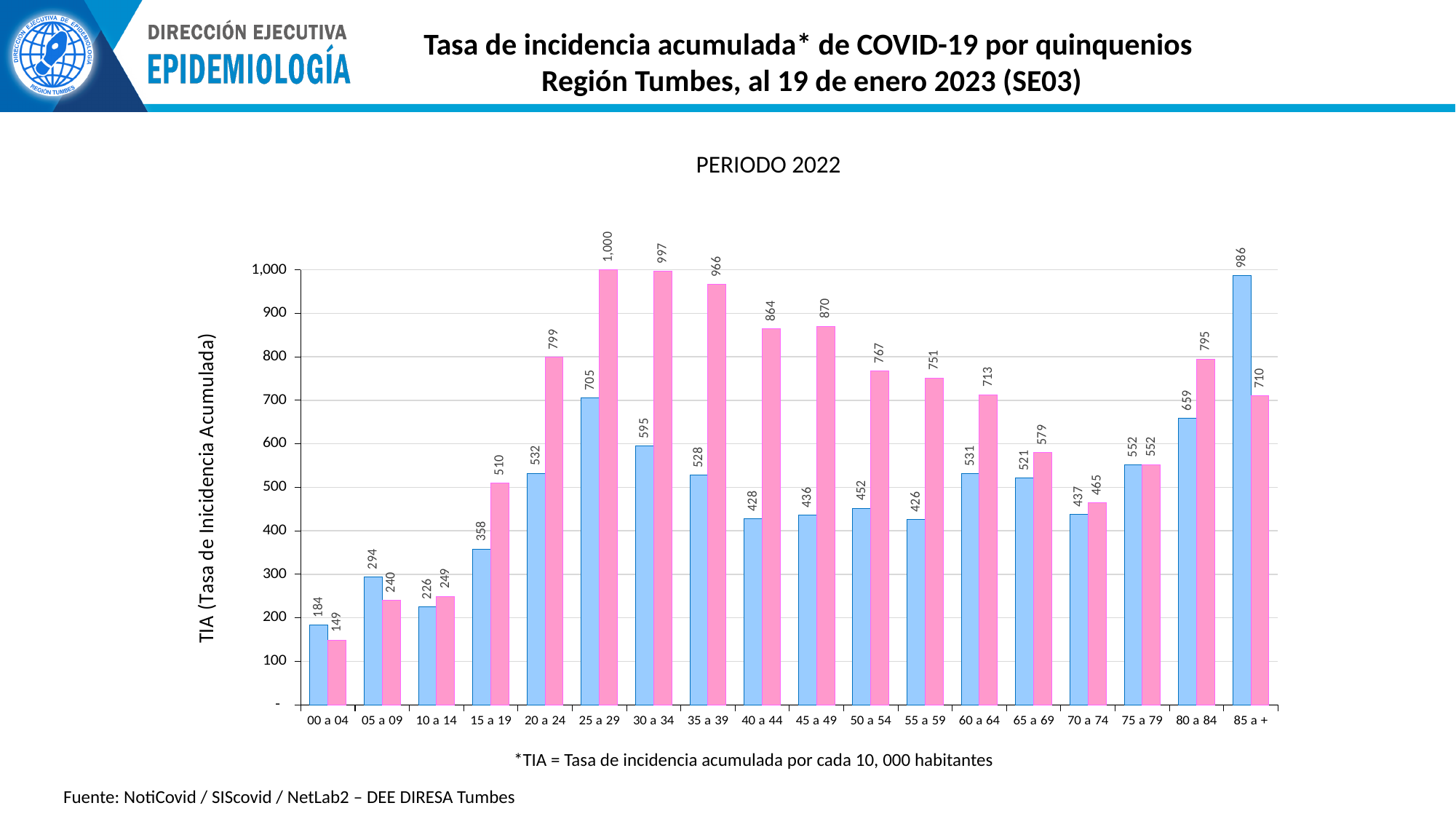
What is the title shown above the chart? PERIODO 2022 What type of chart is shown on the slide? bar chart What is the difference between the pink and blue bars for the 20 a 24 age group? 267 Which age group has the highest blue bar? 85 a + Which age group has the lowest pink bar? 00 a 04 Is the value of the pink bar for the 30 a 34 age group greater or less than 900? greater Which age group has the highest pink bar? 25 a 29 For the 85 a + age group, which bar is larger, the blue or the pink? blue How many age groups are shown on the x axis? 18 What is the value of the pink bar for the 40 a 44 age group? 864 What is the label of the y axis? TIA (Tasa de Incidencia Acumulada) What is the value of the blue bar for the 25 a 29 age group? 705